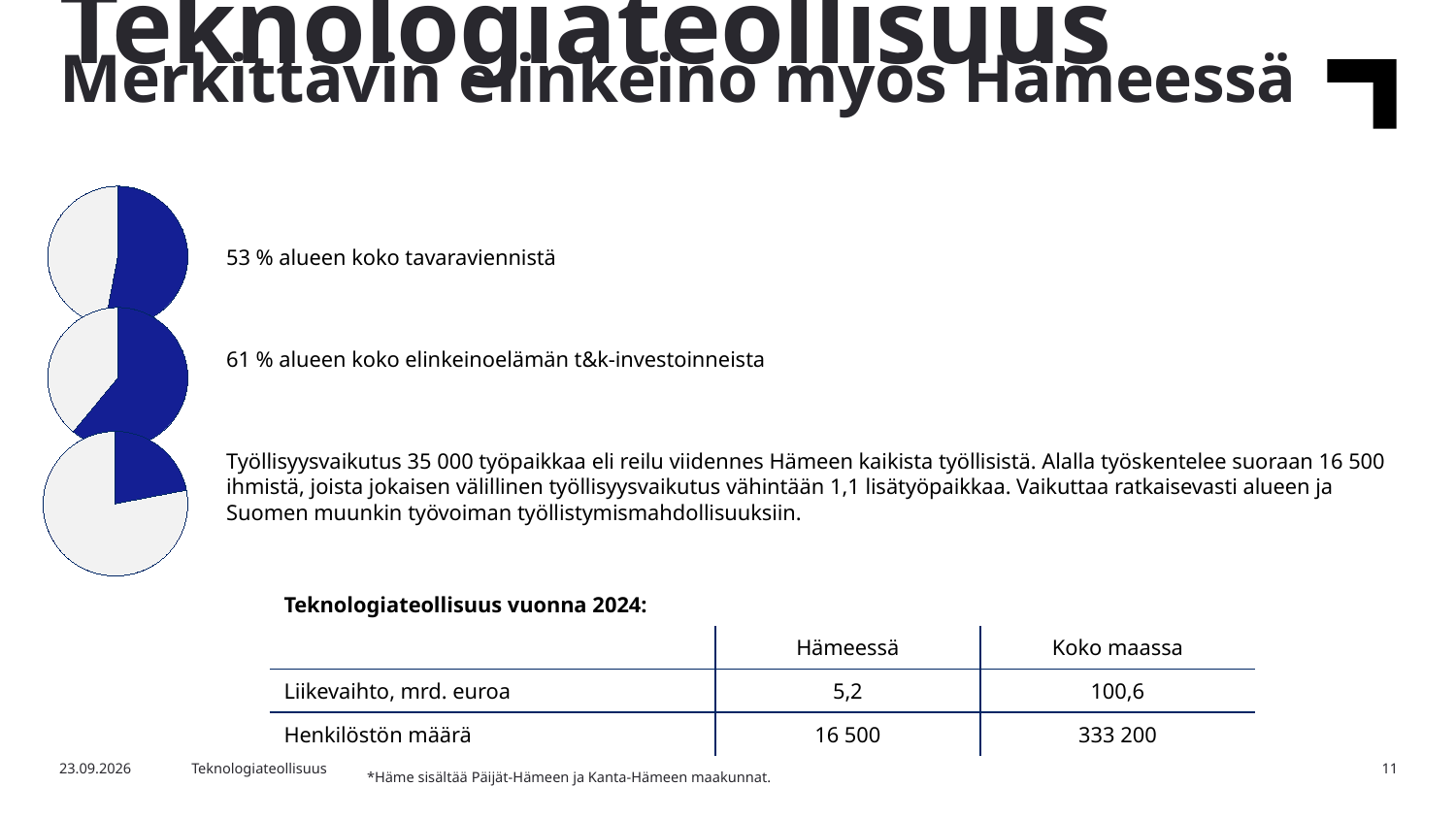
What colour is used for the highlighted slice in the pie charts? Blue How many slices does each pie chart have? 2 Which of the three pie charts has the smallest blue slice? The bottom one (työllisyysvaikutus) Which of the three pie charts has the largest blue slice? The middle one (t&k-investoinnit) How many pie charts are on the slide? 3 What kind of charts are shown on the left side of the slide? Pie charts In the top pie chart, what share of the region's total goods exports (tavaravienti) does the blue slice represent? 53 % In the middle pie chart, what share of the region's business R&D investments (t&k-investoinnit) does the blue slice represent? 61 % Is the blue slice of the middle pie chart greater or less than 50 %? greater What is the difference in percentage points between the blue slices of the middle pie chart (61 %) and the top pie chart (53 %)? 8 percentage points Which pie chart has the larger blue slice, the top one (tavaravienti) or the middle one (t&k-investoinnit)? The middle one (t&k-investoinnit) Is the blue slice of the bottom pie chart greater or less than 50 %? less